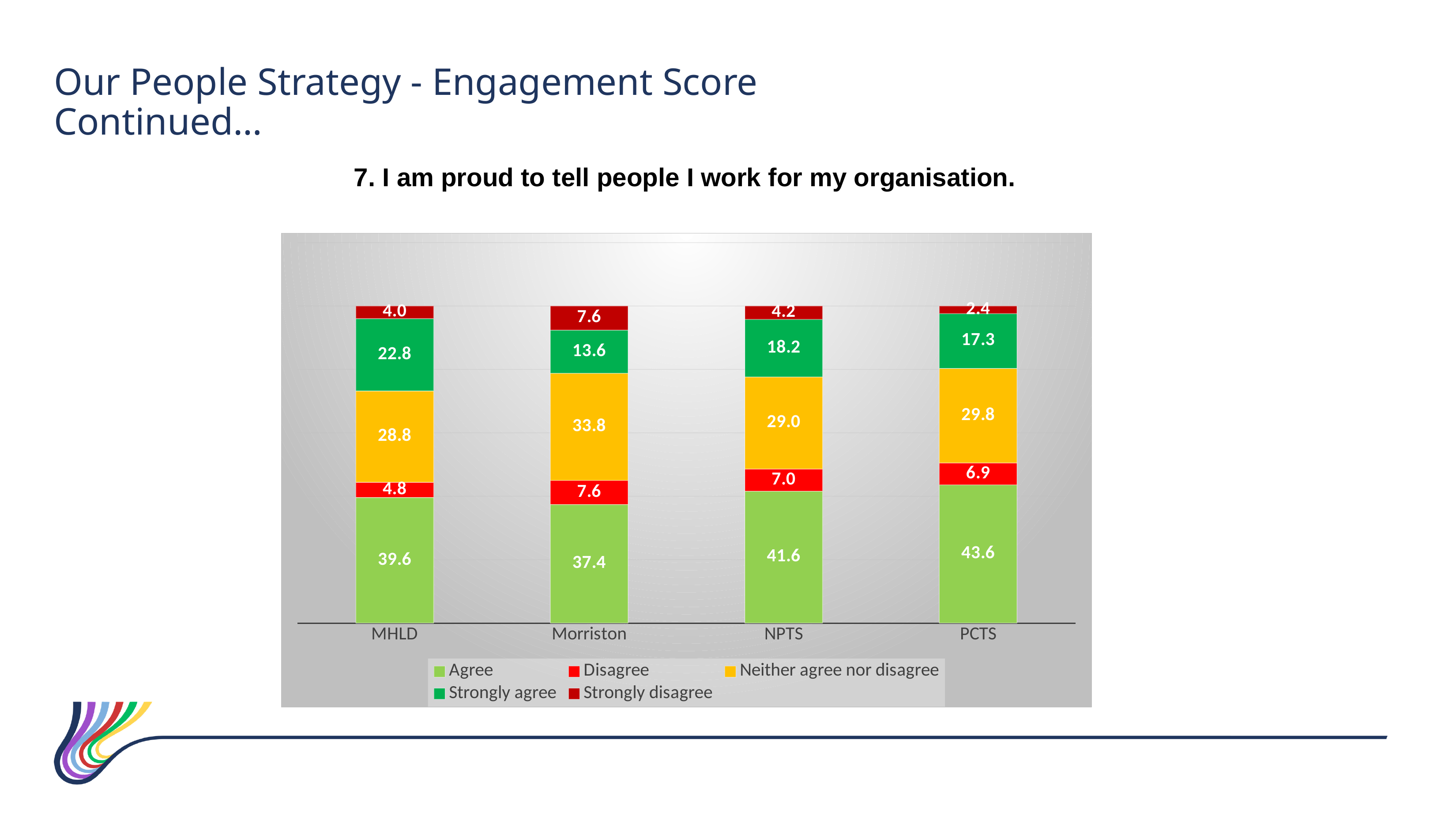
Which category has the highest Agree value? PCTS What is the Neither agree nor disagree value for NPTS? 29.0 What is the difference between the Agree values for PCTS and Morriston? 6.2 How many series does the legend list? 5 Which category has the lowest Strongly disagree value? PCTS Which is larger, the Neither agree nor disagree value for Morriston or for MHLD? Morriston What is the Strongly agree value for Morriston? 13.6 What kind of chart is shown on the slide? Stacked bar chart What is the Strongly disagree value for MHLD? 4.0 What is the Agree value for PCTS? 43.6 Which category has the highest Strongly agree value? MHLD How many categories are shown on the x axis? 4